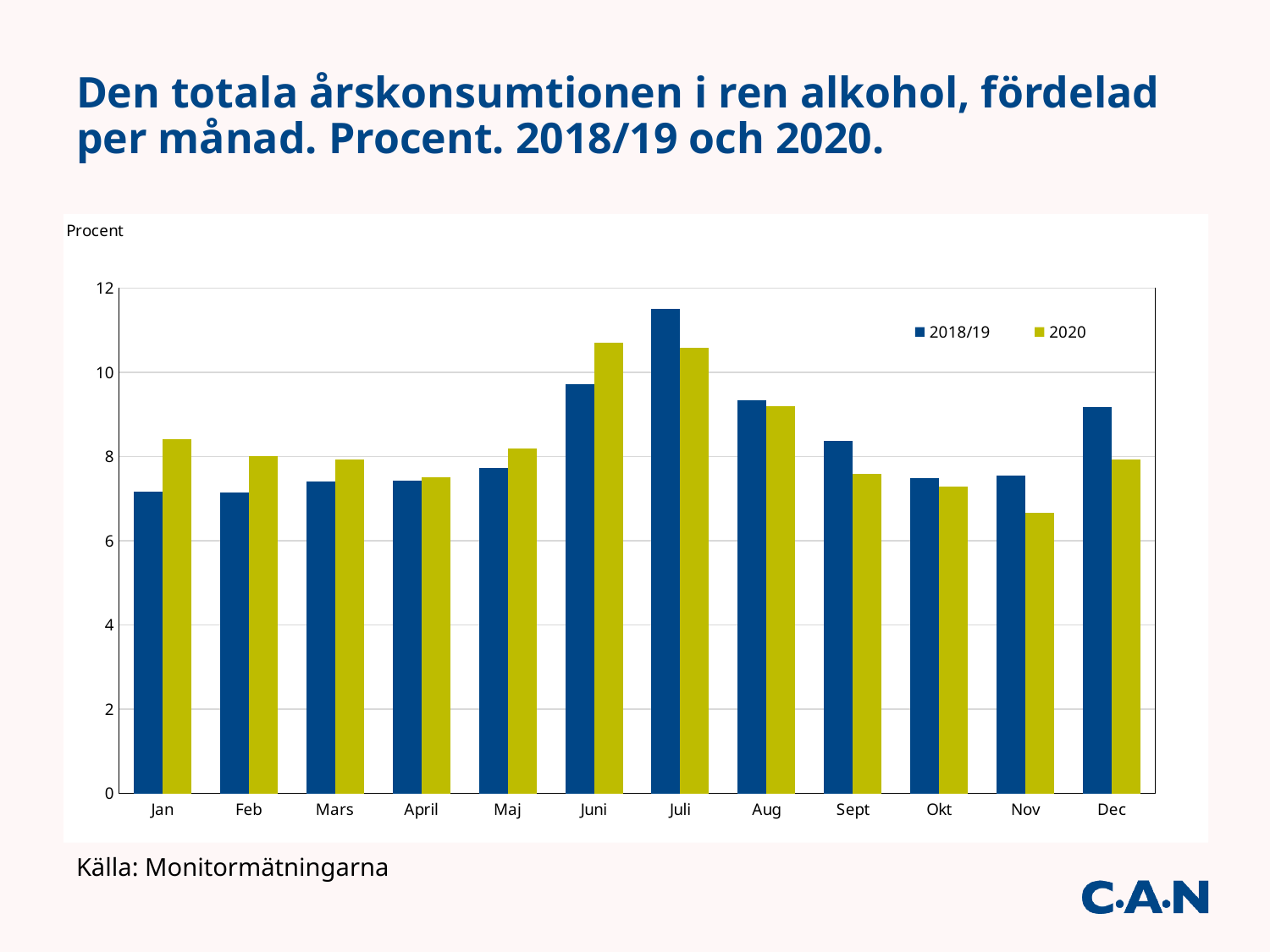
Which month has the highest value for the 2018/19 series? Juli What is the label on the vertical axis of the chart? Procent Is the value for Nov in the 2020 series greater or less than 8? less How many series does the legend list? 2 Is the value for Dec in the 2018/19 series greater or less than 8? greater For Jan, which series has the larger value, 2018/19 or 2020? 2020 For Dec, which series has the larger value, 2018/19 or 2020? 2018/19 How many months are shown on the x axis? 12 Which month has the lowest value for the 2020 series? Nov Is the value for Juli in the 2018/19 series greater or less than 10? greater Do the 2018/19 values rise or fall from Mars to Juli? rise What kind of chart is shown on the slide? Bar chart